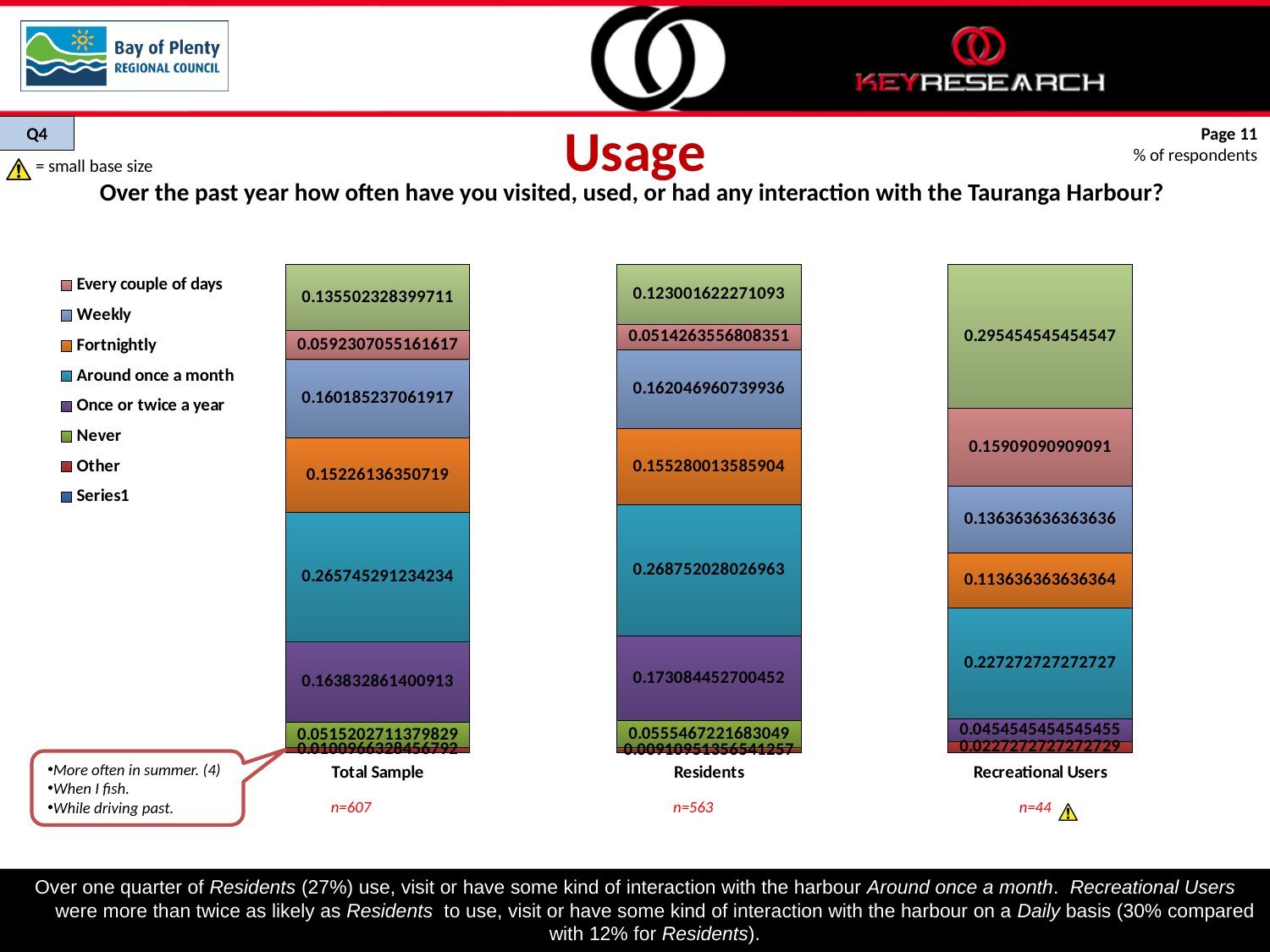
What kind of chart is used to show the usage data on this slide? Stacked bar chart How many entries does the legend list? 8 Which of the three bars contains the single largest segment value? Recreational Users In the Residents bar, what is the value of the top (green) segment? 0.123001622271093 How many stacked bars (groups) are shown on the slide? 3 In the Recreational Users bar, what is the value of the top (green) segment? 0.295454545454547 What is the sample size (n) shown under the Recreational Users bar? n=44 In the Residents bar, what is the value of the teal segment? 0.268752028026963 In the Total Sample bar, what is the value of the purple segment? 0.163832861400913 Which has the larger top (green) segment: the Residents bar or the Recreational Users bar? Recreational Users In the Recreational Users bar, what is the value of the orange segment? 0.113636363636364 In the Total Sample bar, what is the value of the largest (teal) segment? 0.265745291234234